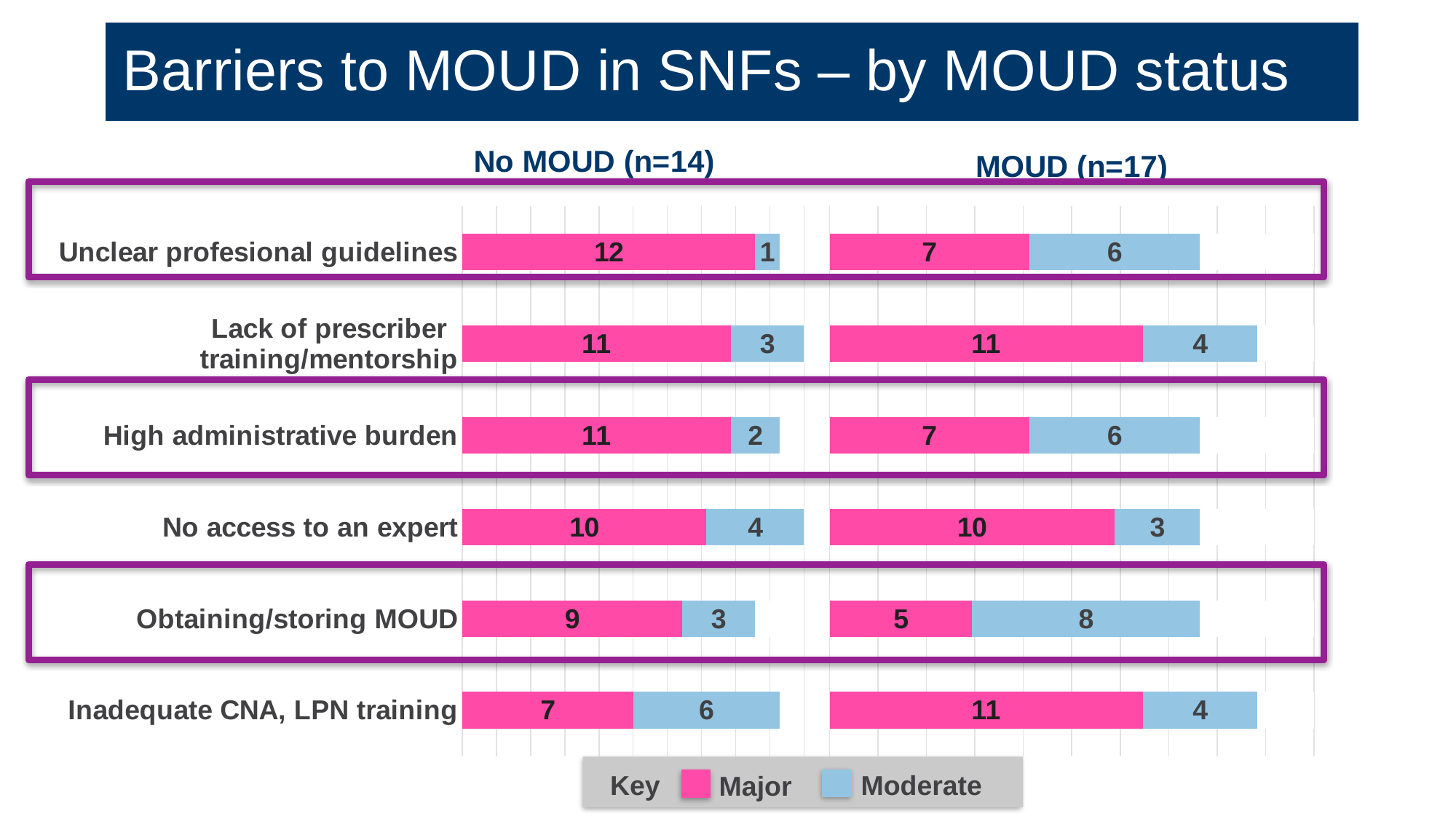
In the MOUD (n=17) chart, what is the total of the stacked bar for Unclear profesional guidelines? 13 In the No MOUD (n=14) chart, which barrier has the highest Major value? Unclear profesional guidelines In the No MOUD (n=14) chart, what is the total of the stacked bar for High administrative burden? 13 In the MOUD (n=17) chart, what is the Major value for Inadequate CNA, LPN training? 11 In the MOUD (n=17) chart, which barrier has the lowest Major value? Obtaining/storing MOUD What kind of chart is used on this slide? Stacked bar chart In the MOUD (n=17) chart, what is the Moderate value for Obtaining/storing MOUD? 8 How many barrier categories are shown in each chart? 6 In the No MOUD (n=14) chart, is the Moderate value for Inadequate CNA, LPN training larger or smaller than the Moderate value for No access to an expert? larger What is the difference between the Major value for Obtaining/storing MOUD in the No MOUD (n=14) chart and in the MOUD (n=17) chart? 4 How many series does the key list? 2 In the No MOUD (n=14) chart, what is the Major value for Unclear profesional guidelines? 12